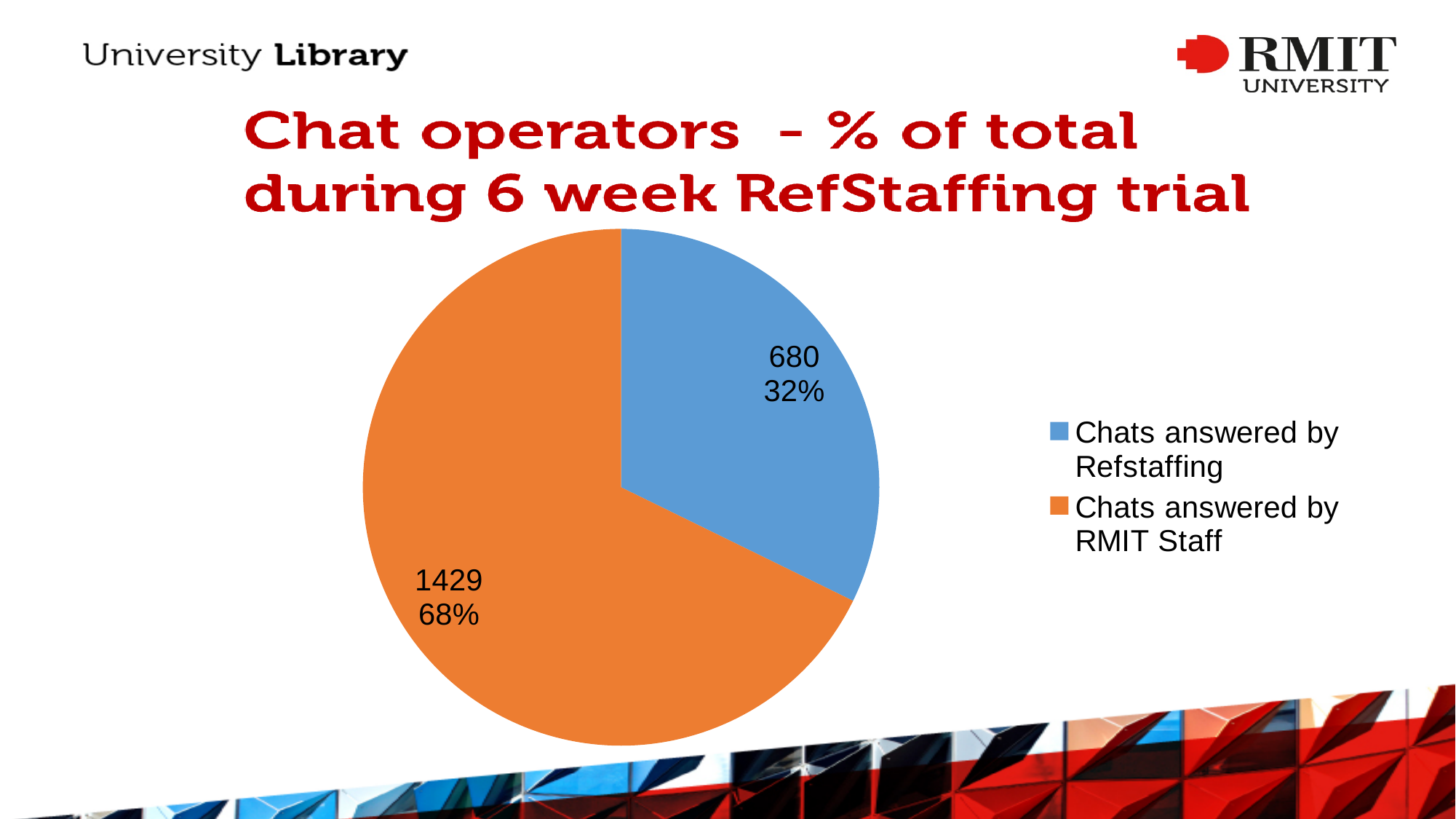
How many categories does the pie chart have? 2 How many chats were answered by Refstaffing? 680 Which category has the smallest slice of the pie? Chats answered by Refstaffing How many chats were answered by RMIT Staff? 1429 Which is larger: chats answered by RMIT Staff or chats answered by Refstaffing? Chats answered by RMIT Staff What colour is the slice for chats answered by RMIT Staff? orange What type of chart is shown on the slide? pie chart What percentage of chats were answered by Refstaffing? 32% How many more chats were answered by RMIT Staff than by Refstaffing? 749 Which category has the largest slice of the pie? Chats answered by RMIT Staff What percentage of chats were answered by RMIT Staff? 68% What is the total number of chats shown in the pie chart? 2109